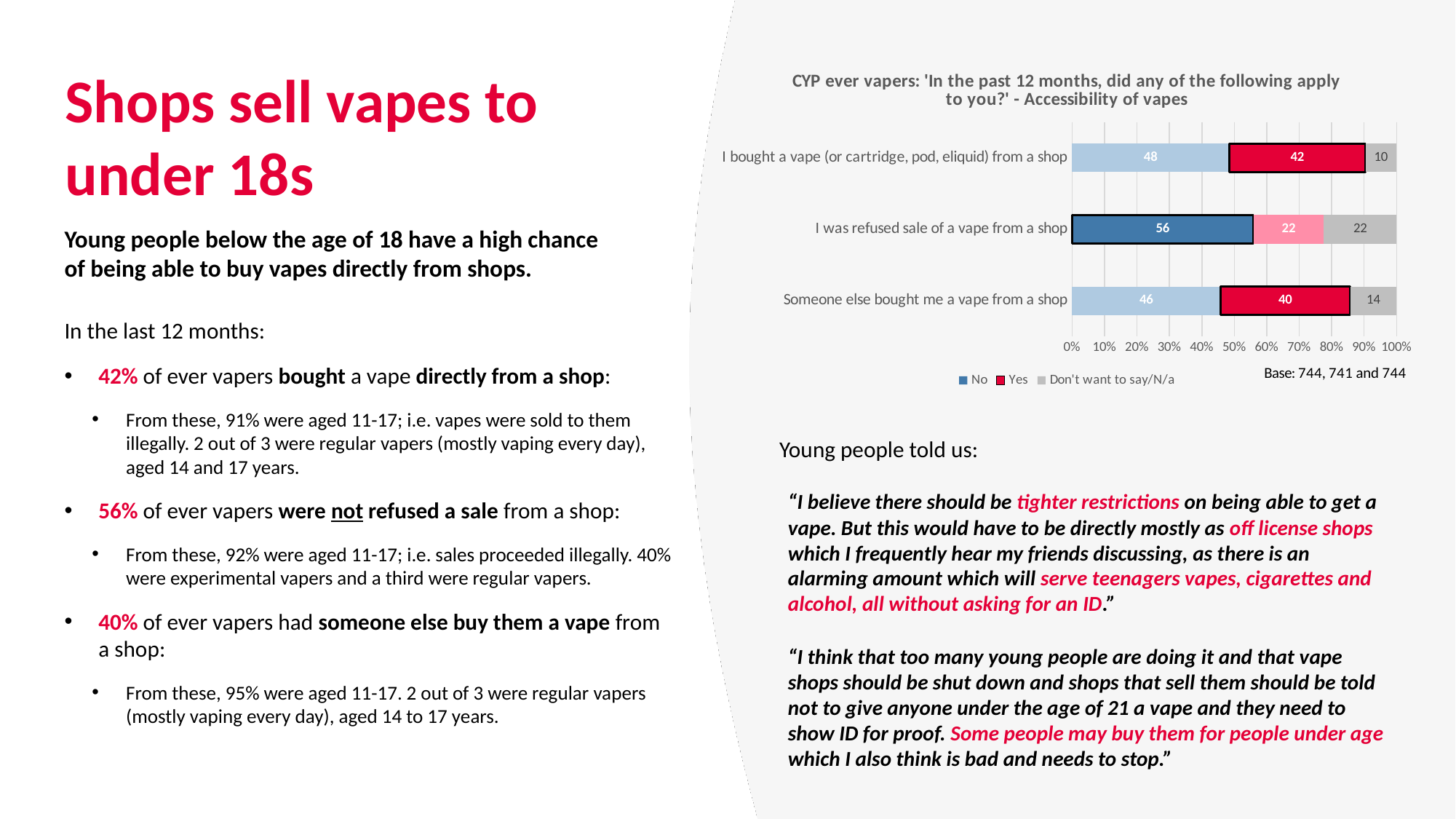
Which category has the lowest 'Yes' value? I was refused sale of a vape from a shop What is the 'Yes' value for 'I bought a vape (or cartridge, pod, eliquid) from a shop'? 42 How many series does the chart legend list? 3 What kind of chart is shown on the slide? Stacked bar chart What is the 'Don't want to say/N/a' value for 'Someone else bought me a vape from a shop'? 14 Which is larger: the 'No' value for 'I bought a vape (or cartridge, pod, eliquid) from a shop' or the 'No' value for 'Someone else bought me a vape from a shop'? I bought a vape (or cartridge, pod, eliquid) from a shop What is the 'No' value for 'I was refused sale of a vape from a shop'? 56 How many categories does the chart show? 3 What is the difference between the 'Yes' values for 'I bought a vape (or cartridge, pod, eliquid) from a shop' and 'Someone else bought me a vape from a shop'? 2 What is the total of the stacked bar for 'I was refused sale of a vape from a shop'? 100 Which category has the highest 'No' value? I was refused sale of a vape from a shop What is the title of the chart? CYP ever vapers: 'In the past 12 months, did any of the following apply to you?' - Accessibility of vapes